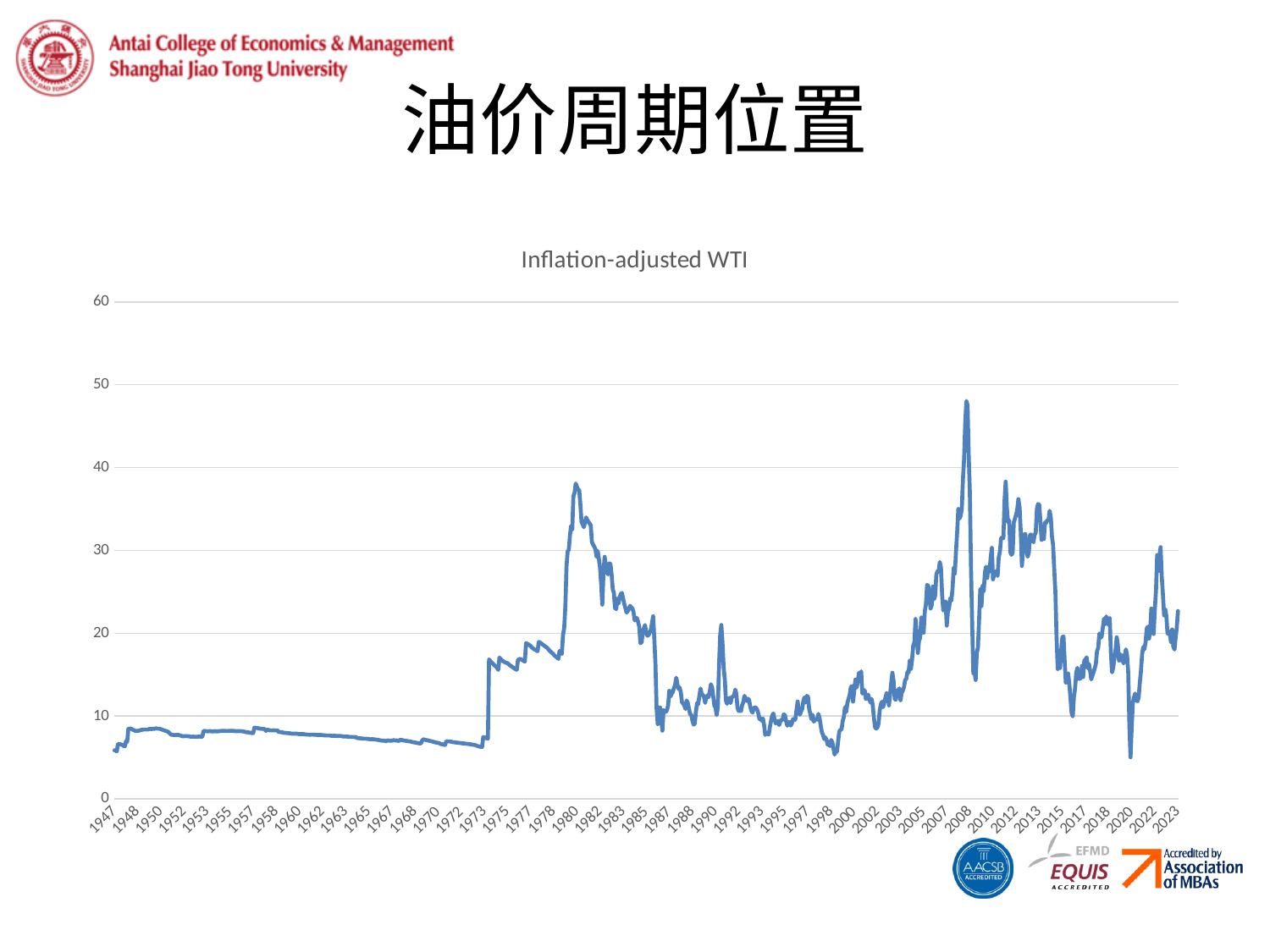
Does the line rise or fall between 1980 and 1986? fall What is the highest value shown on the vertical axis? 60 Which year has the higher value, 1960 or 2012? 2012 Is the peak value around 1980 greater or less than 30? greater Is the value for 1960 greater or less than 10? less What is the title of the chart? Inflation-adjusted WTI Is the lowest value around 2020 greater or less than 10? less Around which year does the inflation-adjusted WTI line reach its highest point? 2008 What kind of chart is shown on the slide? line chart Does the line rise or fall between 2002 and 2008? rise Which peak is higher, the one around 1980 or the one around 2008? 2008